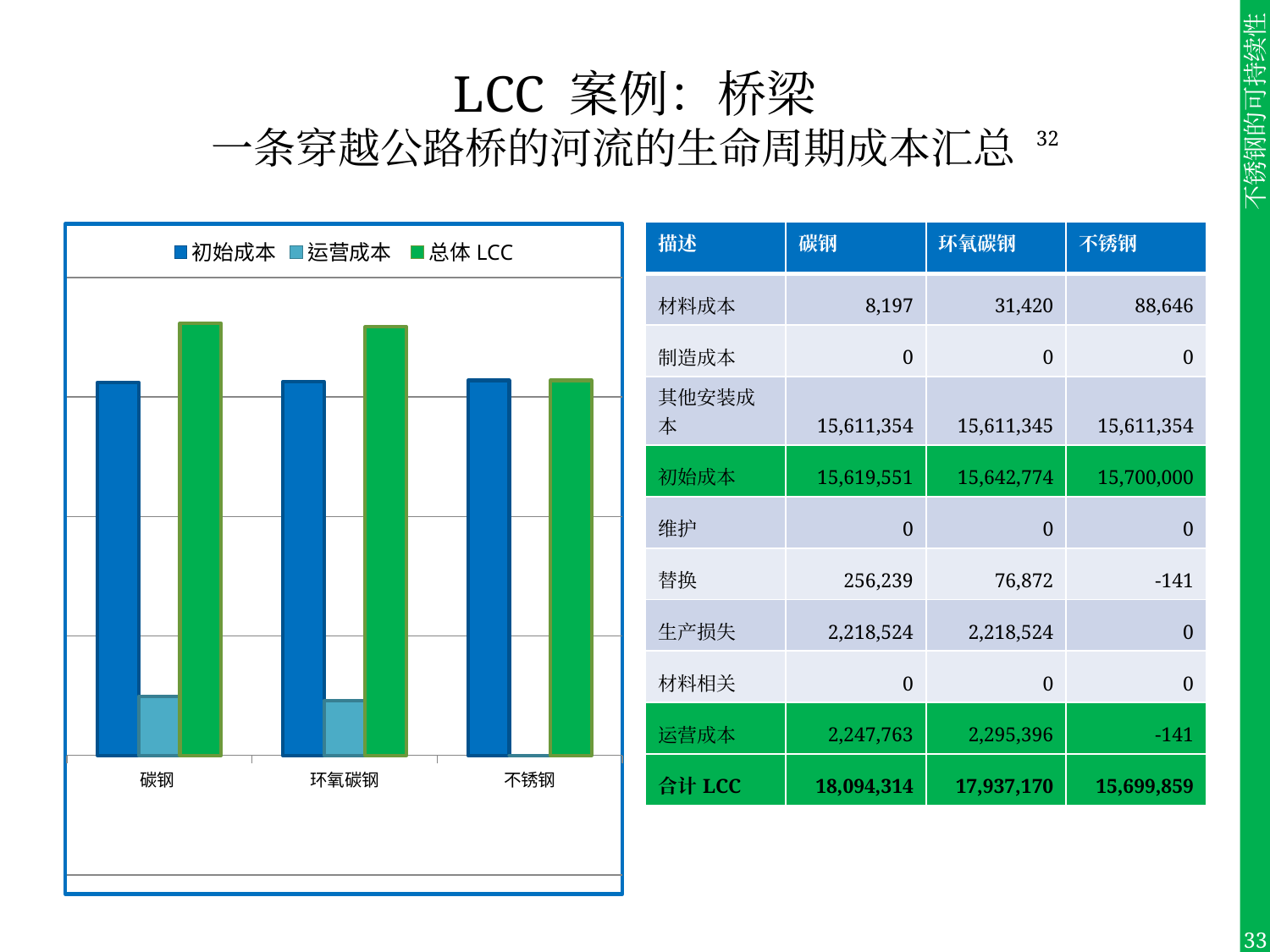
For 碳钢, which is larger in the chart: 初始成本 or 总体 LCC? 总体 LCC How many categories are shown on the x axis of the bar chart? 3 What kind of chart is shown on the left of the slide? bar chart Which colour represents 总体 LCC in the bar chart? green Do the 总体 LCC bars rise or fall from 碳钢 to 不锈钢 along the x axis? fall According to the table on the slide, what is the 合计 LCC value for 不锈钢? 15,699,859 Which category has the lowest 总体 LCC bar in the chart? 不锈钢 According to the table on the slide, what is the 运营成本 value for 碳钢? 2,247,763 Which category has the highest 总体 LCC bar in the chart? 碳钢 Which category has the lowest 运营成本 bar in the chart? 不锈钢 What are the three series named in the legend of the bar chart? 初始成本, 运营成本, 总体 LCC How many series does the legend of the bar chart list? 3